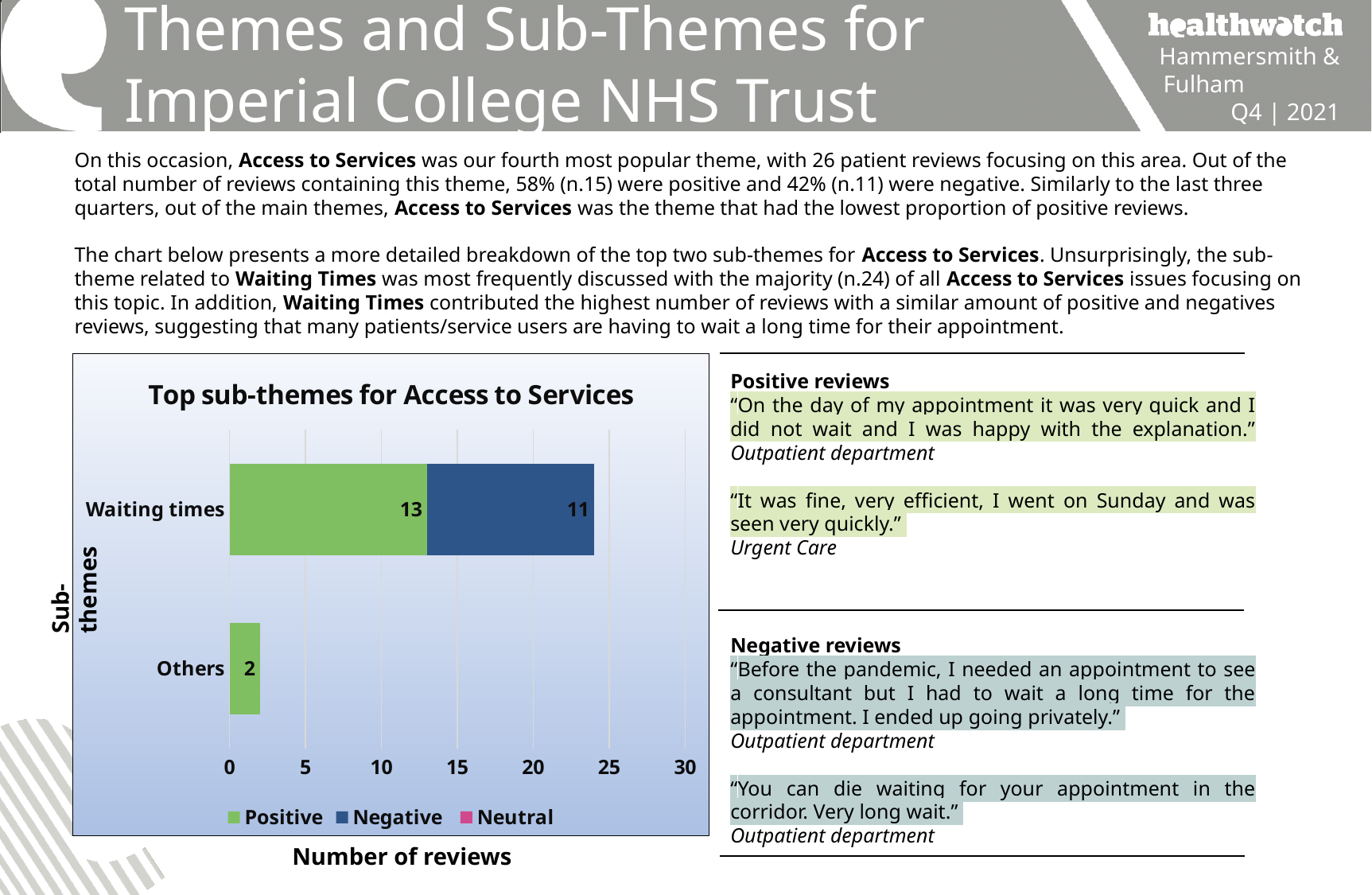
What is the title of the chart? Top sub-themes for Access to Services How many negative reviews are shown for Waiting times? 11 How many positive reviews are shown for Waiting times? 13 How many series does the legend list? 3 What type of chart is shown? Bar chart What is the difference between positive and negative reviews for Waiting times? 2 What is the label of the x axis? Number of reviews Which sub-theme has the highest total number of reviews? Waiting times How many sub-theme categories are shown on the chart? 2 What is the total number of reviews for Waiting times? 24 How many positive reviews are shown for Others? 2 Which is larger for Waiting times: positive or negative reviews? Positive